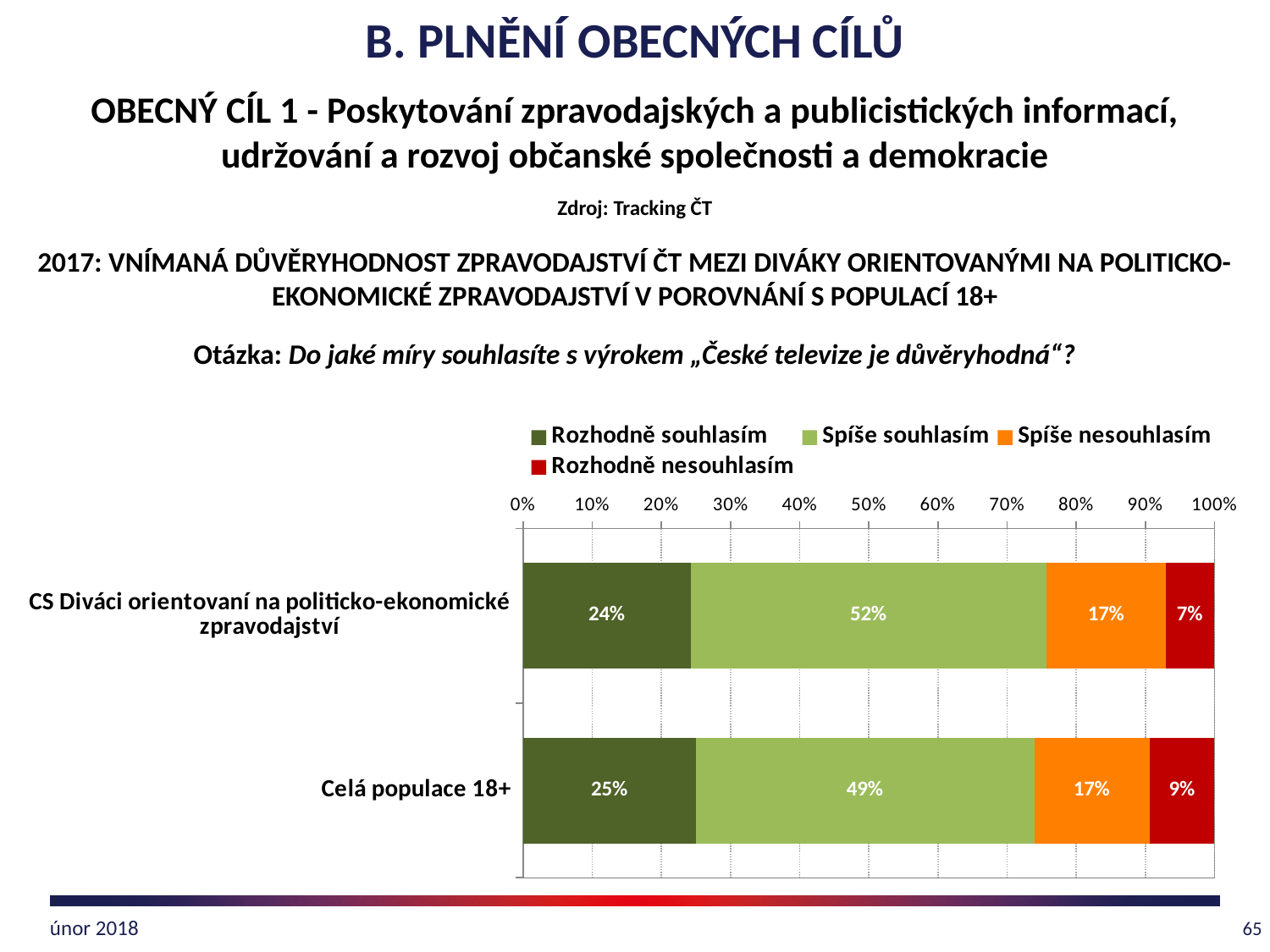
What is the value of "Spíše souhlasím" for "CS Diváci orientovaní na politicko-ekonomické zpravodajství"? 52% What is the difference between the "Rozhodně nesouhlasím" values for "Celá populace 18+" and "CS Diváci orientovaní na politicko-ekonomické zpravodajství"? 2% What is the value of "Rozhodně souhlasím" for "Celá populace 18+"? 25% Which category has the higher value for "Spíše souhlasím"? CS Diváci orientovaní na politicko-ekonomické zpravodajství What is the value of "Spíše nesouhlasím" for "CS Diváci orientovaní na politicko-ekonomické zpravodajství"? 17% How many categories (bars) are shown in the chart? 2 What is the value of "Rozhodně nesouhlasím" for "Celá populace 18+"? 9% What is the source cited for the chart data? Tracking ČT Which segment is the largest in the bar for "Celá populace 18+"? Spíše souhlasím What kind of chart is shown on the slide? stacked bar chart What is the total of the "Rozhodně souhlasím" and "Spíše souhlasím" segments for "Celá populace 18+"? 74% How many series does the legend list? 4